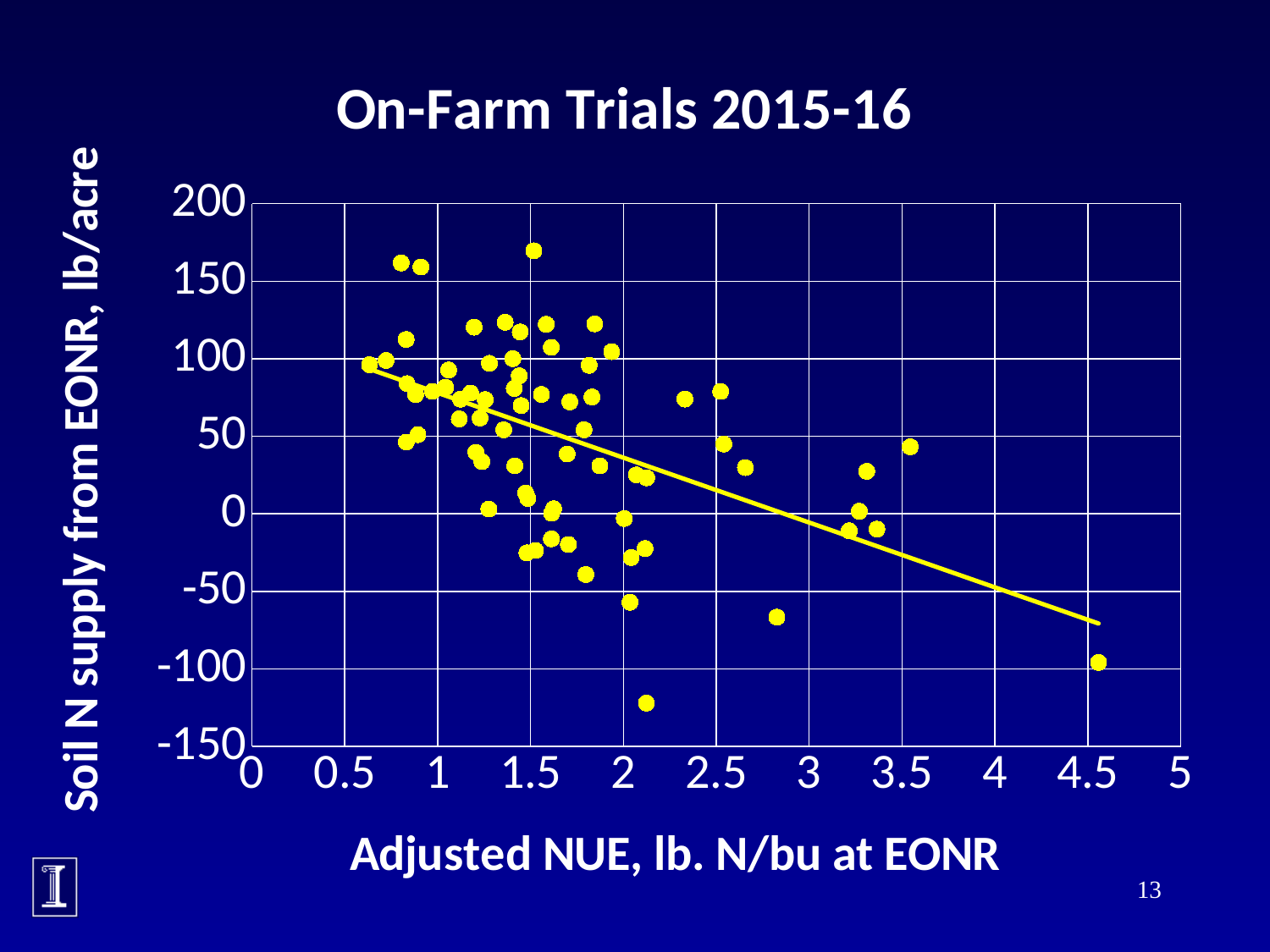
What is the title of the chart? On-Farm Trials 2015-16 Is the soil N supply value for the point near 2.8 on the x axis greater or less than -50? less Is the value of the trend line at its right end (near 4.5 on the x axis) greater or less than -50? less Is the value of the trend line at its left end (near 0.6 on the x axis) greater or less than 50? greater What kind of chart is shown on the slide? scatter chart Which has the higher soil N supply value: the point near 3.5 on the x axis or the point near 4.5 on the x axis? the point near 3.5 What is the label of the x axis? Adjusted NUE, lb. N/bu at EONR Does the fitted trend line rise or fall as Adjusted NUE increases along the x axis? fall